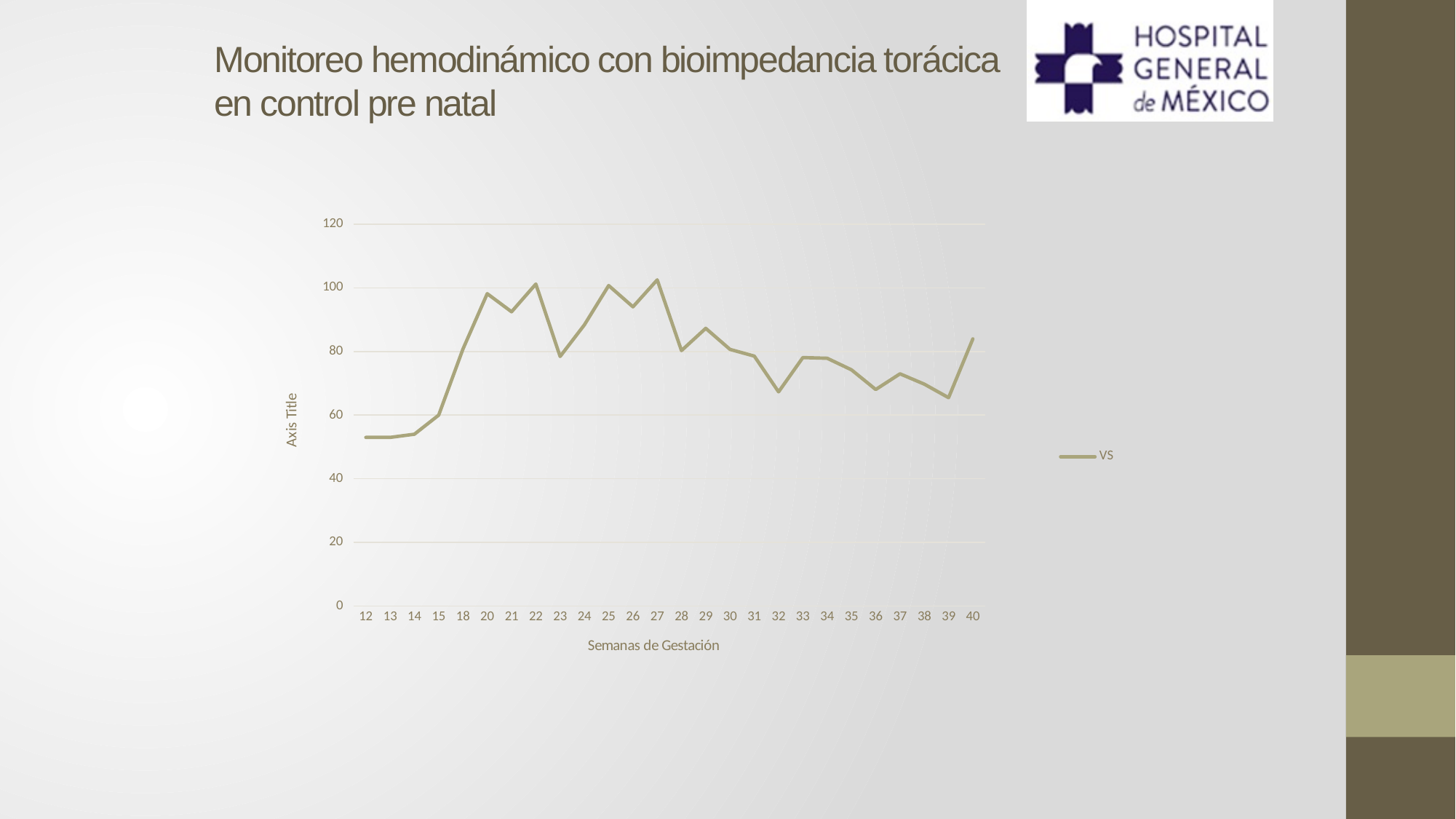
Is the value for week 12 greater or less than 60? less Do the values rise or fall from week 12 to week 20? rise Which has the larger value, week 20 or week 32? week 20 What kind of chart is shown on the slide? line chart What is the title of the x axis? Semanas de Gestación How many gestation weeks are plotted along the x axis? 26 What is the name of the series shown in the legend? VS How many series does the legend list? 1 Is the value for week 40 greater or less than 80? greater Is the value for week 32 greater or less than 60? greater